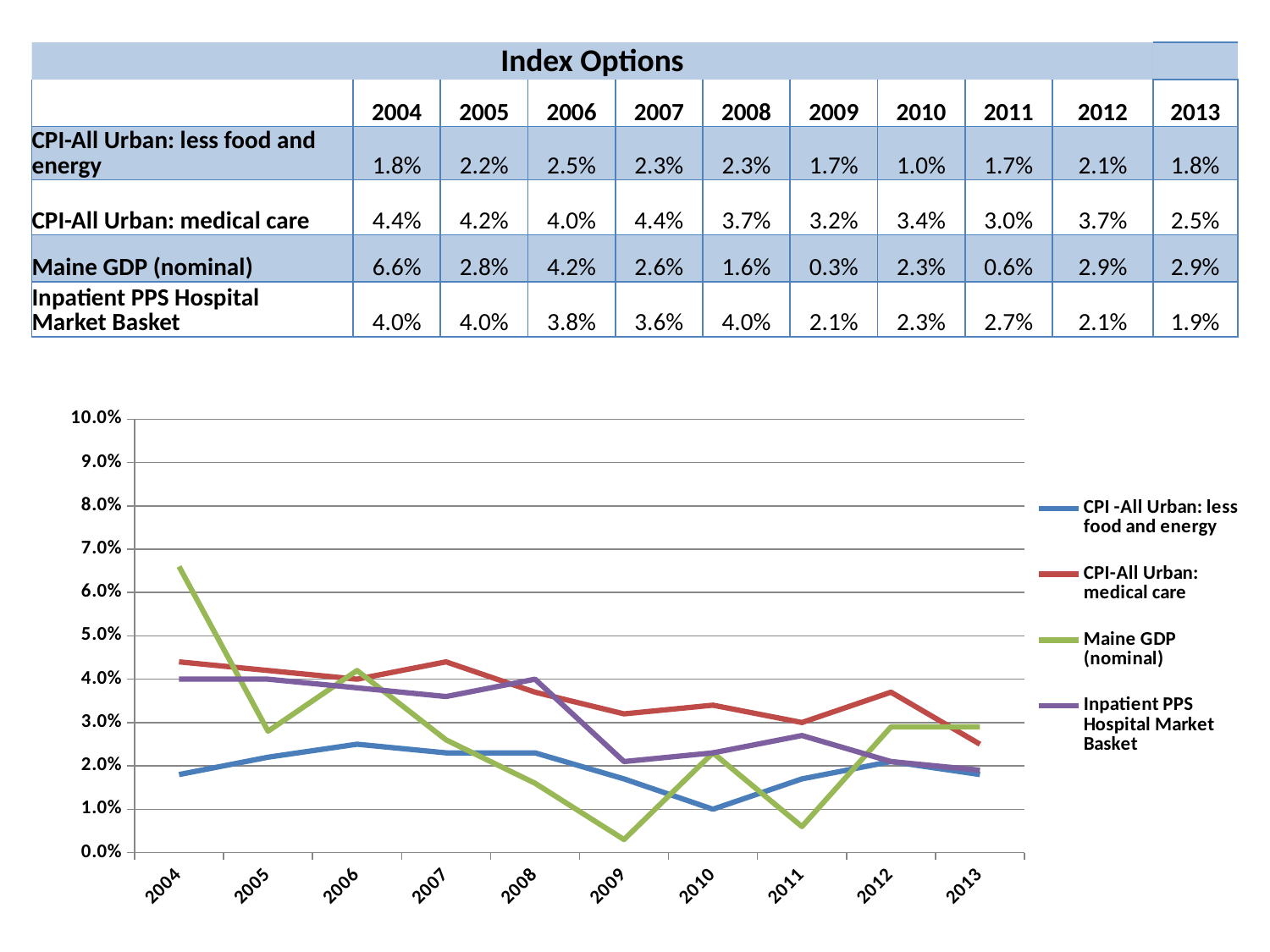
How many series does the chart legend list? 4 Which series has the lowest value in 2009? Maine GDP (nominal) Does the CPI-All Urban: medical care series generally rise or fall from 2004 to 2013? fall Which series has the highest value in 2004? Maine GDP (nominal) What is the value for CPI-All Urban: medical care in 2007? 4.4% Is the value for Maine GDP (nominal) in 2004 greater or less than 6.0%? greater What is the value for Maine GDP (nominal) in 2004? 6.6% What kind of chart is shown on the slide? line chart How many years are plotted along the x axis of the chart? 10 Which is larger in 2012, Maine GDP (nominal) or Inpatient PPS Hospital Market Basket? Maine GDP (nominal) What is the difference between CPI-All Urban: medical care and CPI-All Urban: less food and energy in 2010? 2.4% What is the value for Inpatient PPS Hospital Market Basket in 2013? 1.9%